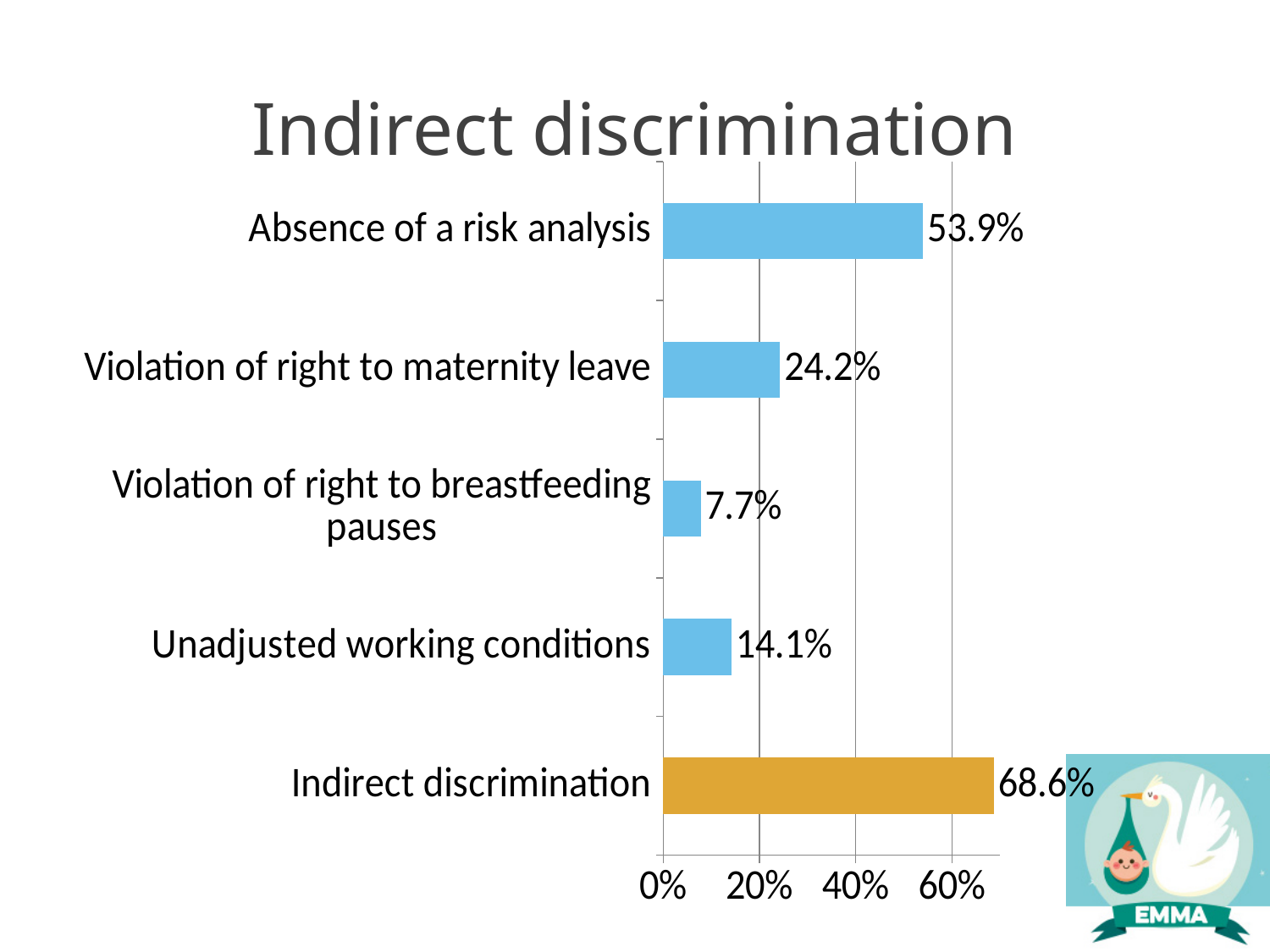
Which category has the highest value? Indirect discrimination What is the value for Violation of right to maternity leave? 24.2% What is the difference between the values for Indirect discrimination and Absence of a risk analysis? 14.7% What is the value for Absence of a risk analysis? 53.9% What is the value for Indirect discrimination? 68.6% What is the value for Violation of right to breastfeeding pauses? 7.7% Which category has the lowest value? Violation of right to breastfeeding pauses What kind of chart is shown on the slide? Bar chart Which is larger, the value for Violation of right to maternity leave or the value for Unadjusted working conditions? Violation of right to maternity leave How many categories are shown in the chart? 5 Is the value for Absence of a risk analysis greater or less than 40%? greater What is the value for Unadjusted working conditions? 14.1%